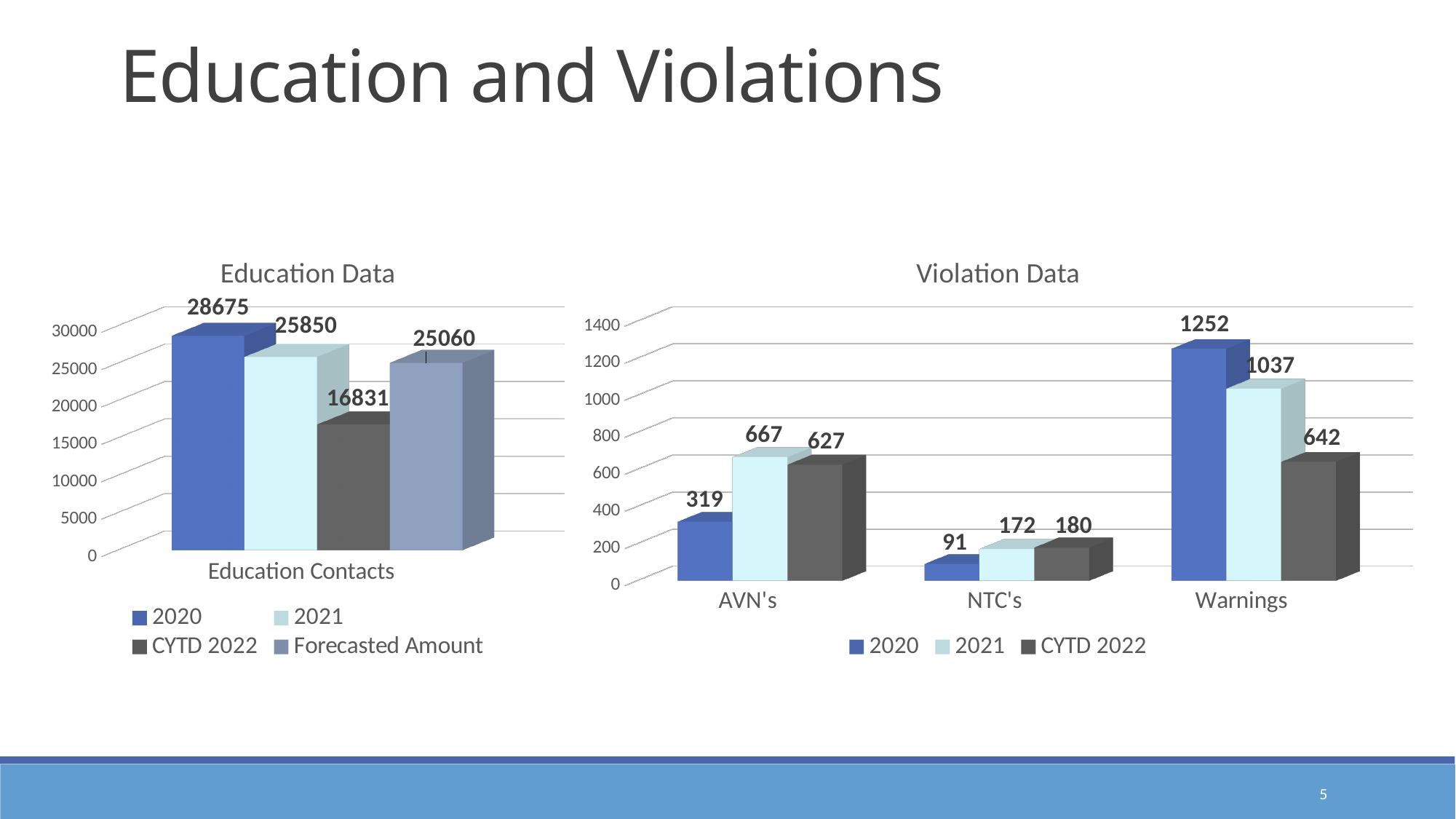
In the Education Data chart, what is the value for 2020 Education Contacts? 28675 In the Education Data chart, what is the difference between the 2020 and 2021 values for Education Contacts? 2825 In the Violation Data chart, which category has the highest 2020 value? Warnings In the Violation Data chart, what is the 2021 value for AVN's? 667 What kind of chart is the Violation Data chart? Bar chart In the Violation Data chart, which is larger for NTC's: the 2021 value or the CYTD 2022 value? CYTD 2022 How many series does the legend of the Education Data chart list? 4 How many categories are shown on the x axis of the Violation Data chart? 3 In the Education Data chart, which series has the lowest value for Education Contacts? CYTD 2022 In the Violation Data chart, what is the difference between the 2020 and 2021 values for Warnings? 215 In the Education Data chart, what is the Forecasted Amount for Education Contacts? 25060 In the Violation Data chart, what is the CYTD 2022 value for Warnings? 642